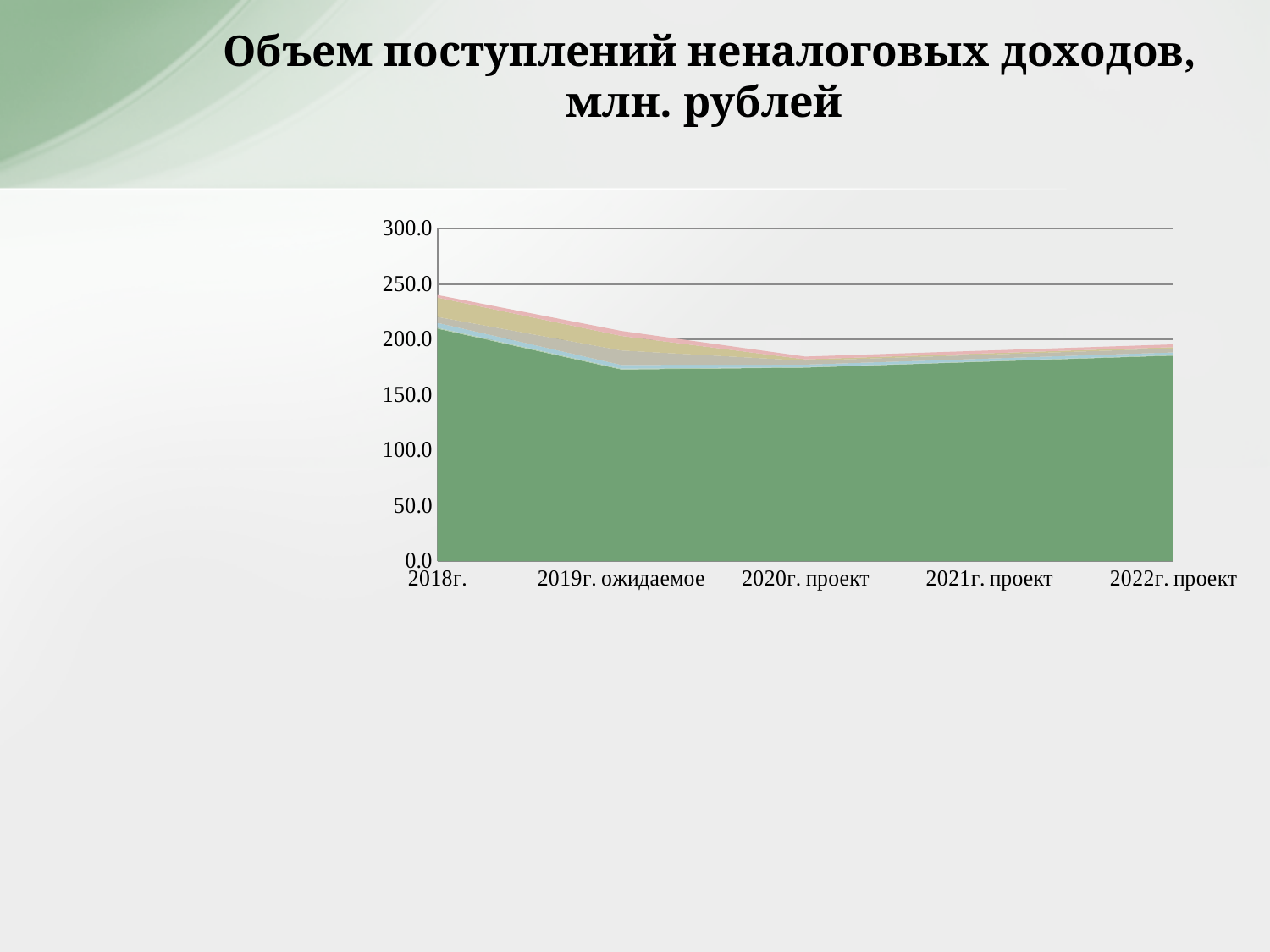
Is the total stacked value for 2018г. greater or less than 250? less Is the value of the bottom (dark green) series for 2019г. ожидаемое greater or less than 200? less Is the total stacked value for 2021г. проект greater or less than 150? greater How many categories are shown along the x axis? 5 What is the title of the chart? Объем поступлений неналоговых доходов, млн. рублей Which has the larger total stacked value, 2018г. or 2022г. проект? 2018г. What is the highest value shown on the y axis? 300.0 Which category has the highest total stacked value? 2018г. What kind of chart is shown on the slide? area chart Does the total stacked value rise or fall from 2018г. to 2020г. проект? fall